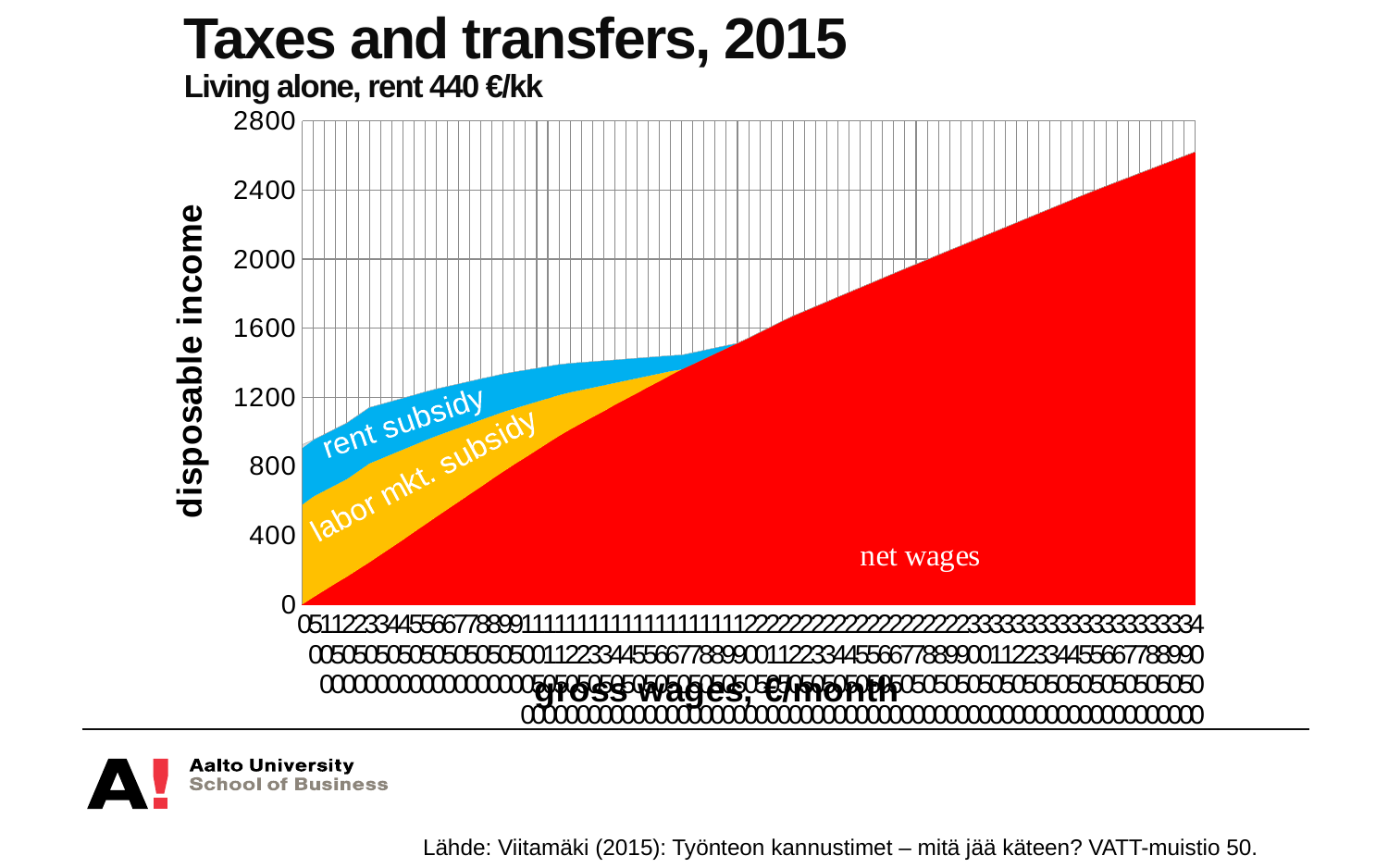
At the lowest gross wage shown (zero), is the total disposable income greater or less than 1200? less What kind of chart is shown on the slide? stacked area chart What is the highest tick value shown on the vertical axis? 2800 At the highest gross wage shown, is the total disposable income greater or less than 2400? greater Which series is larger at the highest gross wage: net wages or rent subsidy? net wages At the lowest gross wage shown (zero), is the net wages value greater or less than 400? less How many series (areas) are plotted in the chart? 3 Which series is larger at the lowest gross wage: net wages or labor mkt. subsidy? labor mkt. subsidy Does the net wages area rise or fall as gross wages increase along the x axis? rise What is the title of the chart on the slide? Taxes and transfers, 2015 What is the label of the vertical axis? disposable income